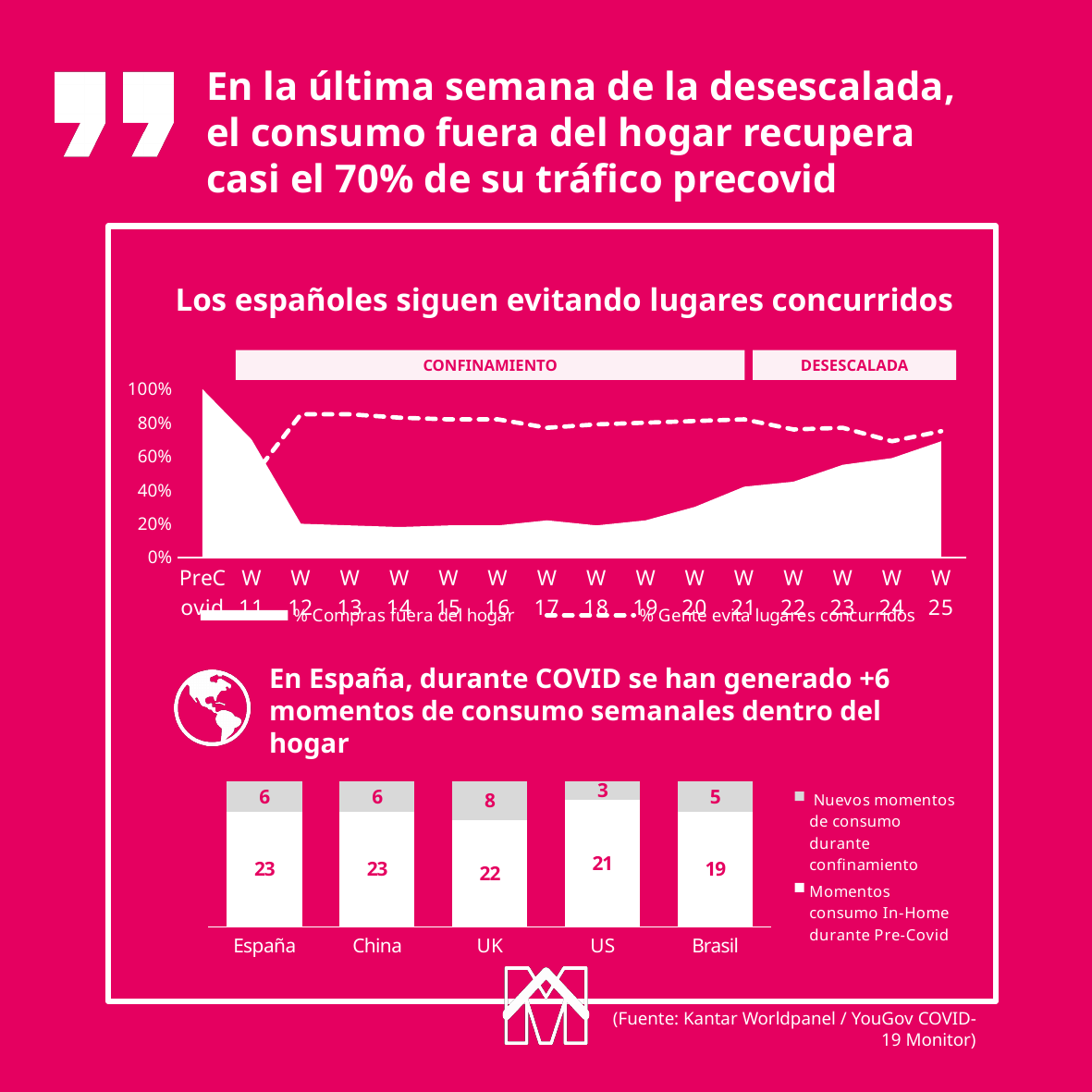
In the top chart 'Los españoles siguen evitando lugares concurridos', is the value of '% Compras fuera del hogar' at W 25 greater or less than 60%? greater In the bottom chart, which country has the lowest number of new consumption moments during confinement? US In the bottom chart, what is the difference between the pre-Covid in-home moments for España and Brasil? 4 In the bottom chart, what is the total of the stacked bar for UK? 30 In the bottom chart, which country has the highest number of new consumption moments during confinement? UK In the bottom chart, how many countries are shown? 5 In the bottom chart, what is the value of 'Momentos consumo In-Home durante Pre-Covid' for Brasil? 19 In the top chart 'Los españoles siguen evitando lugares concurridos', is the value of '% Compras fuera del hogar' at W 12 greater or less than 40%? less In the bottom chart, how many series does the legend list? 2 In the bottom chart, how many new consumption moments during confinement are shown for UK? 8 In the bottom chart, which country has the lowest value for pre-Covid in-home consumption moments? Brasil In the top chart 'Los españoles siguen evitando lugares concurridos', how many points are on the x axis? 16